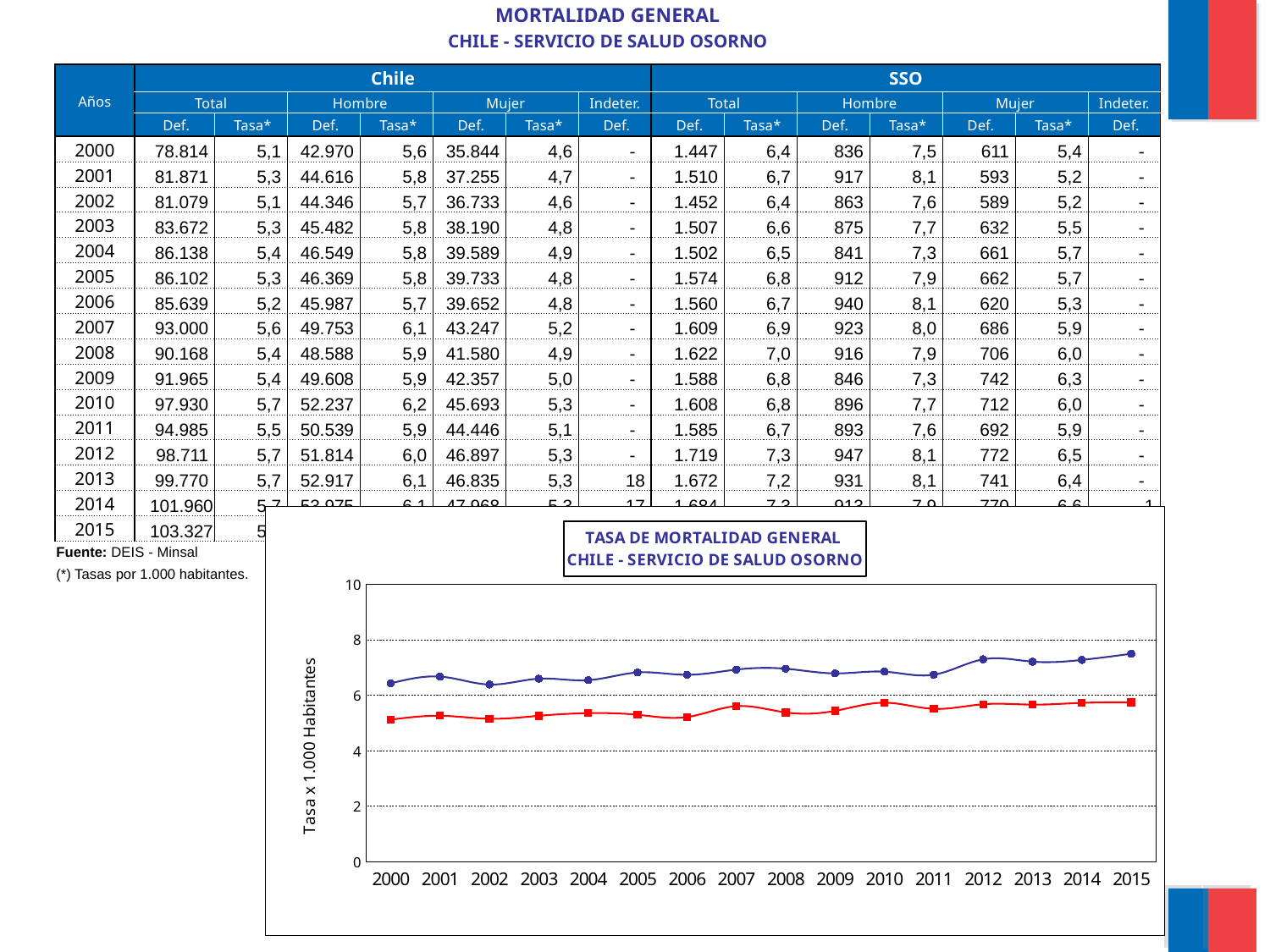
What is the highest value shown on the vertical axis of the chart? 10 Is the value of the red line in 2000 greater or less than 6? less Is the value of the red line in 2015 greater or less than 4? greater In 2010, which line has the higher value, the blue line or the red line? the blue line What is the title of the chart on the slide? TASA DE MORTALIDAD GENERAL CHILE - SERVICIO DE SALUD OSORNO How many years are plotted along the x axis of the chart? 16 How many lines are plotted in the chart? 2 Is the value of the blue line in 2015 greater or less than 8? less Does the blue line rise or fall overall from 2000 to 2015? rise What is the label of the vertical axis of the chart? Tasa x 1.000 Habitantes What type of chart is shown on the slide? line chart